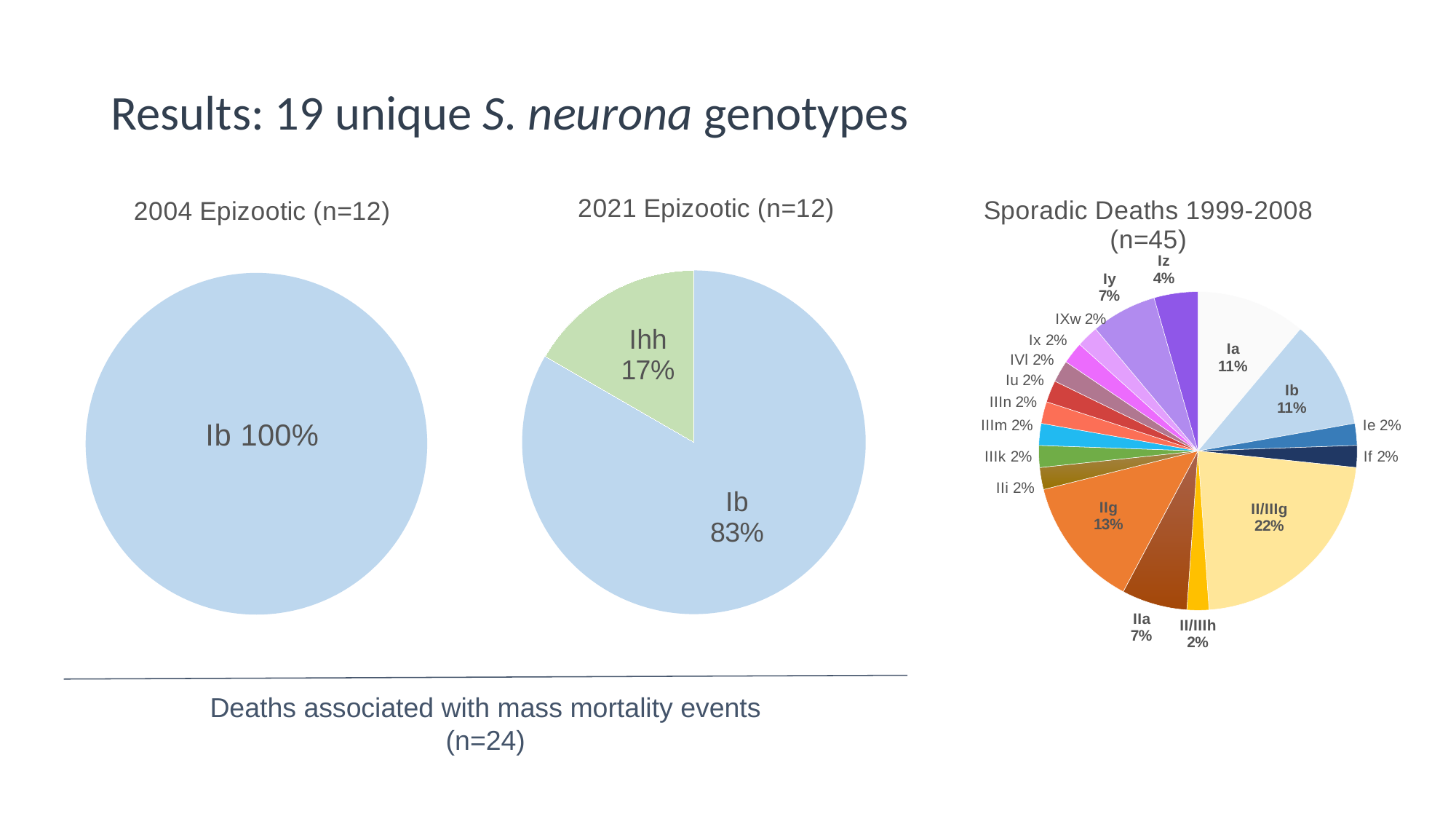
In the 2021 Epizootic (n=12) chart, which has the larger share, Ib or Ihh? Ib In the 2021 Epizootic (n=12) chart, what share does genotype Ib have? 83% What kind of chart is used for the 2004 Epizootic (n=12) data? Pie chart In the 2021 Epizootic (n=12) chart, what share does genotype Ihh have? 17% What is the title of the rightmost chart on the slide? Sporadic Deaths 1999-2008 (n=45) In the Sporadic Deaths 1999-2008 (n=45) chart, which has the larger share, Iy or Iz? Iy In the Sporadic Deaths 1999-2008 (n=45) chart, what is the difference in share between II/IIIg and IIg? 9% In the Sporadic Deaths 1999-2008 (n=45) chart, what share does genotype IIg have? 13% In the Sporadic Deaths 1999-2008 (n=45) chart, what share does genotype II/IIIg have? 22% In the Sporadic Deaths 1999-2008 (n=45) chart, which genotype has the largest share? II/IIIg How many slices does the Sporadic Deaths 1999-2008 (n=45) chart have? 18 In the 2004 Epizootic (n=12) chart, what share does genotype Ib have? 100%